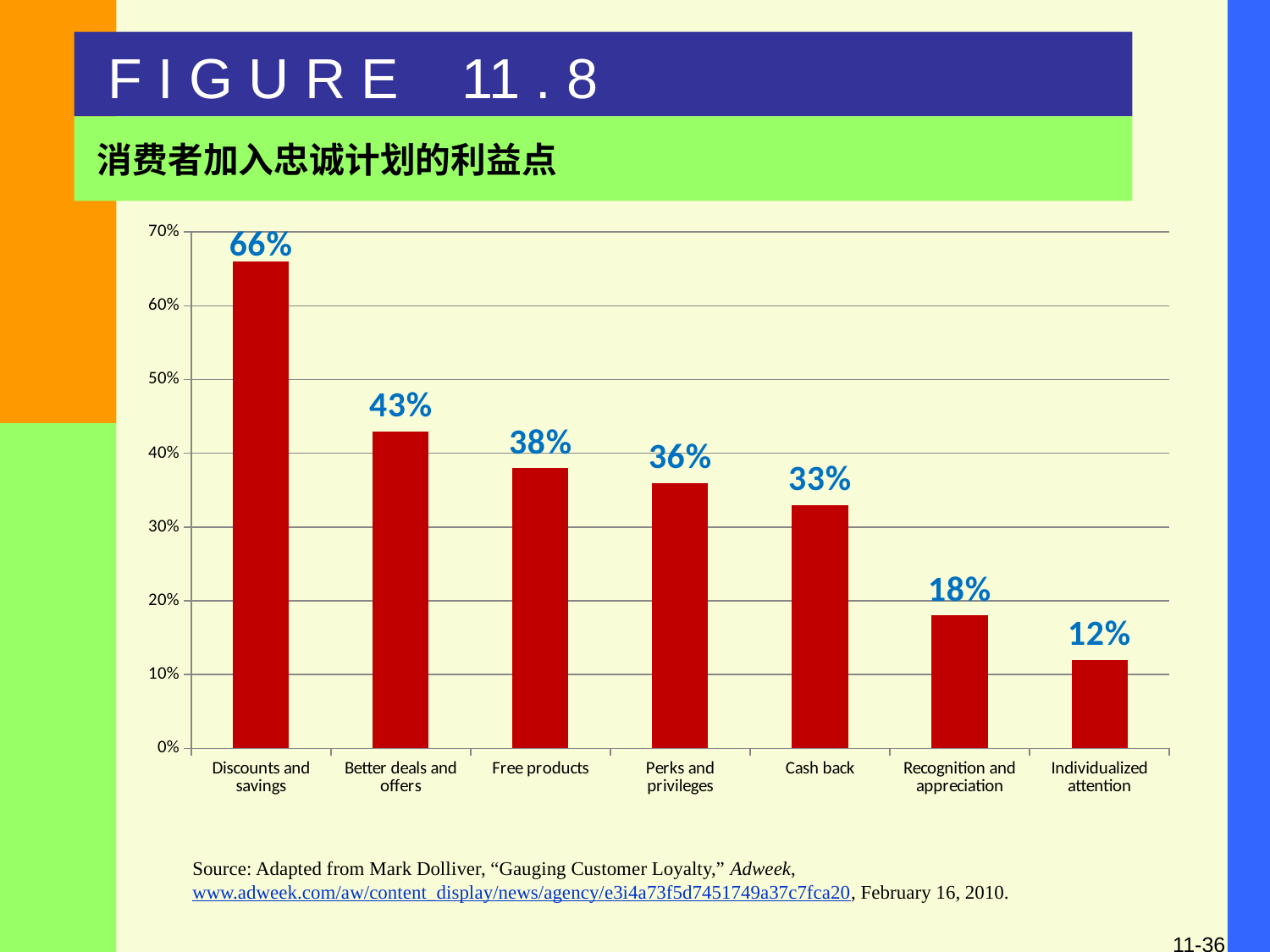
Which category has the lowest value? Individualized attention How many categories are shown on the x axis? 7 What is the difference between the values for Discounts and savings and Individualized attention? 54% Is the value for Free products greater or less than 30%? greater Which category has the highest value? Discounts and savings What kind of chart is shown on the slide? Bar chart What is the difference between the values for Better deals and offers and Free products? 5% Which is larger, the value for Perks and privileges or the value for Cash back? Perks and privileges What is the value for Recognition and appreciation? 18% Do the values rise or fall from left to right along the x axis? Fall What is the value for Discounts and savings? 66% What is the value for Cash back? 33%